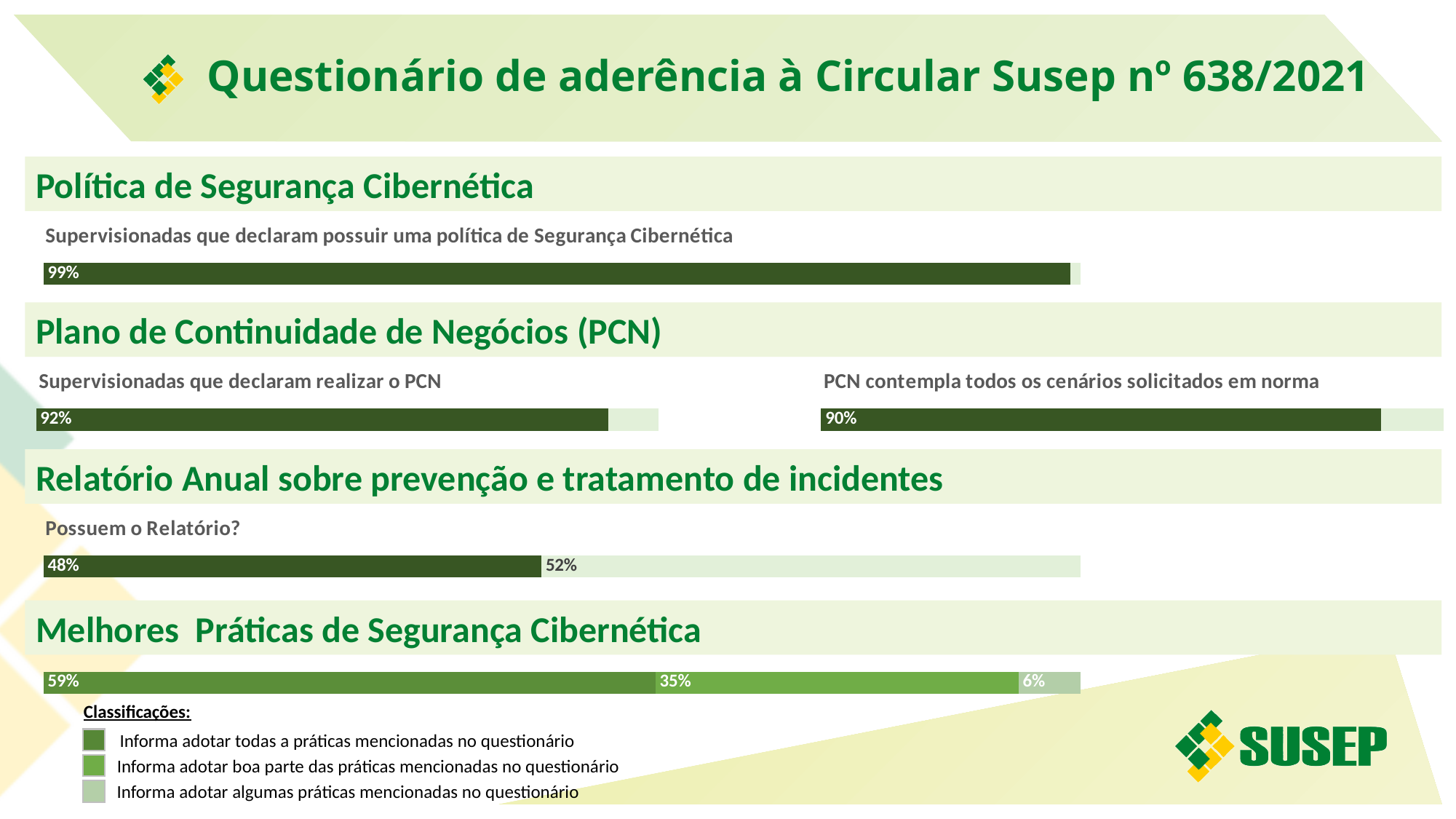
In the 'Plano de Continuidade de Negócios (PCN)' section, what percentage of supervised entities declare carrying out the PCN? 92% In the 'Plano de Continuidade de Negócios (PCN)' section, which is larger: the share that declare carrying out the PCN or the share whose PCN covers all required scenarios? Supervisionadas que declaram realizar o PCN In the 'Plano de Continuidade de Negócios (PCN)' section, what percentage is shown for 'PCN contempla todos os cenários solicitados em norma'? 90% In the 'Melhores Práticas de Segurança Cibernética' chart, how many classifications does the legend list? 3 In the 'Melhores Práticas de Segurança Cibernética' chart, what percentage report adopting all the practices mentioned in the questionnaire? 59% What type of chart is used in the 'Melhores Práticas de Segurança Cibernética' section? Stacked horizontal bar chart In the 'Melhores Práticas de Segurança Cibernética' chart, which classification has the smallest share? Informa adotar algumas práticas mencionadas no questionário In the 'Plano de Continuidade de Negócios (PCN)' section, what is the difference between the 92% and 90% values? 2% In the 'Relatório Anual sobre prevenção e tratamento de incidentes' chart, what percentage is shown in the dark green segment for 'Possuem o Relatório?'? 48% In the 'Melhores Práticas de Segurança Cibernética' chart, what percentage report adopting only some of the practices mentioned in the questionnaire? 6% In the 'Política de Segurança Cibernética' chart, what percentage of supervised entities declare having a cybersecurity policy? 99% In the 'Relatório Anual sobre prevenção e tratamento de incidentes' chart, what percentage is shown in the light segment of the bar? 52%